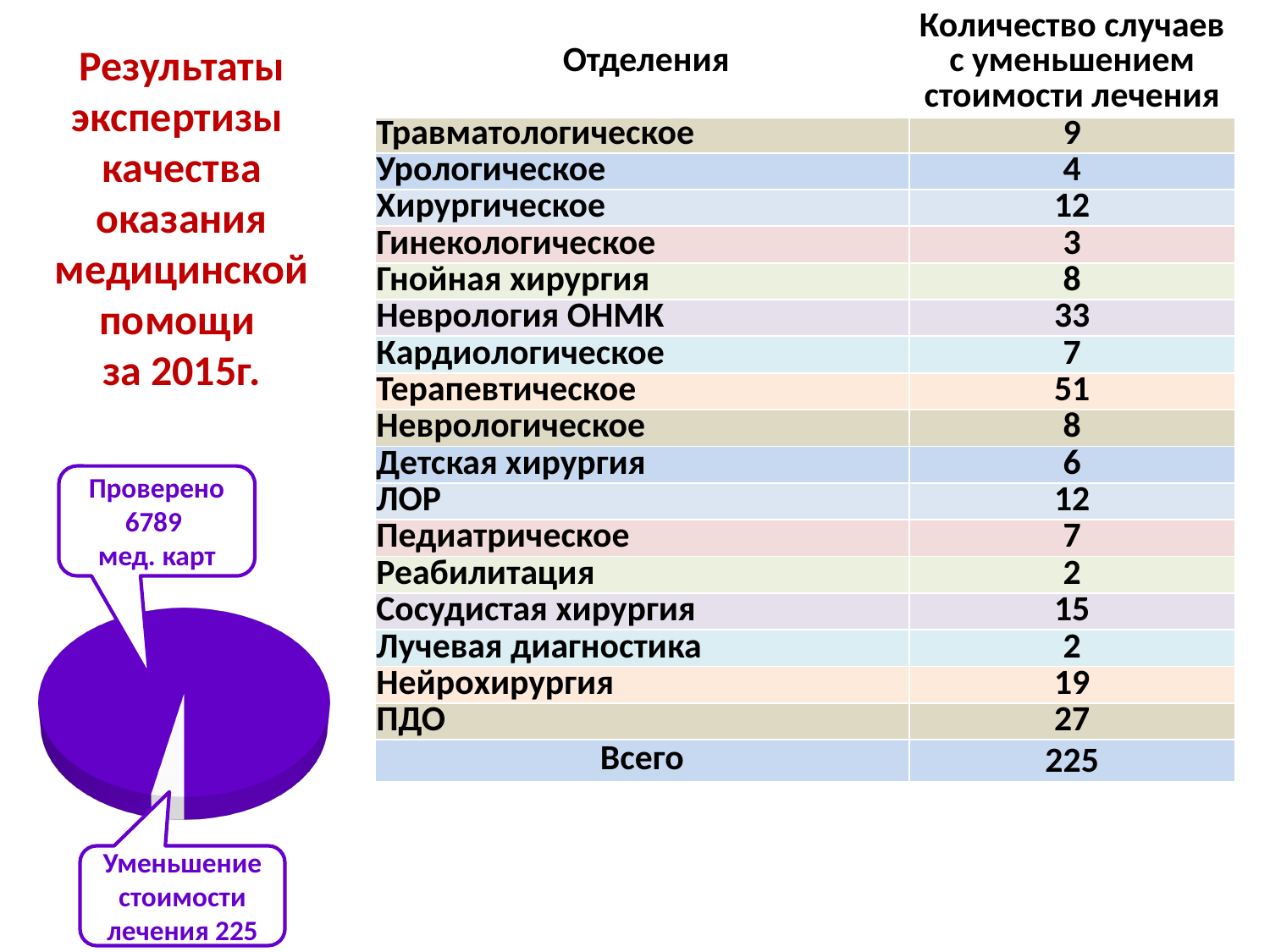
What value is shown for the slice labelled "Уменьшение стоимости лечения" in the pie chart? 225 What kind of chart is shown on the slide? pie chart Which is larger in the pie chart: the number of checked medical records (Проверено мед. карт) or the number of cases with reduced treatment cost (Уменьшение стоимости лечения)? Проверено мед. карт What value is shown for the slice labelled "Проверено ... мед. карт" in the pie chart? 6789 How many slices does the pie chart have? 2 Which slice of the pie chart is the largest? Проверено 6789 мед. карт What is the difference between the two values shown on the pie chart, 6789 and 225? 6564 What year does the slide title say the results refer to? 2015 Which slice of the pie chart is the smallest? Уменьшение стоимости лечения 225 What colour is the large slice of the pie chart? purple